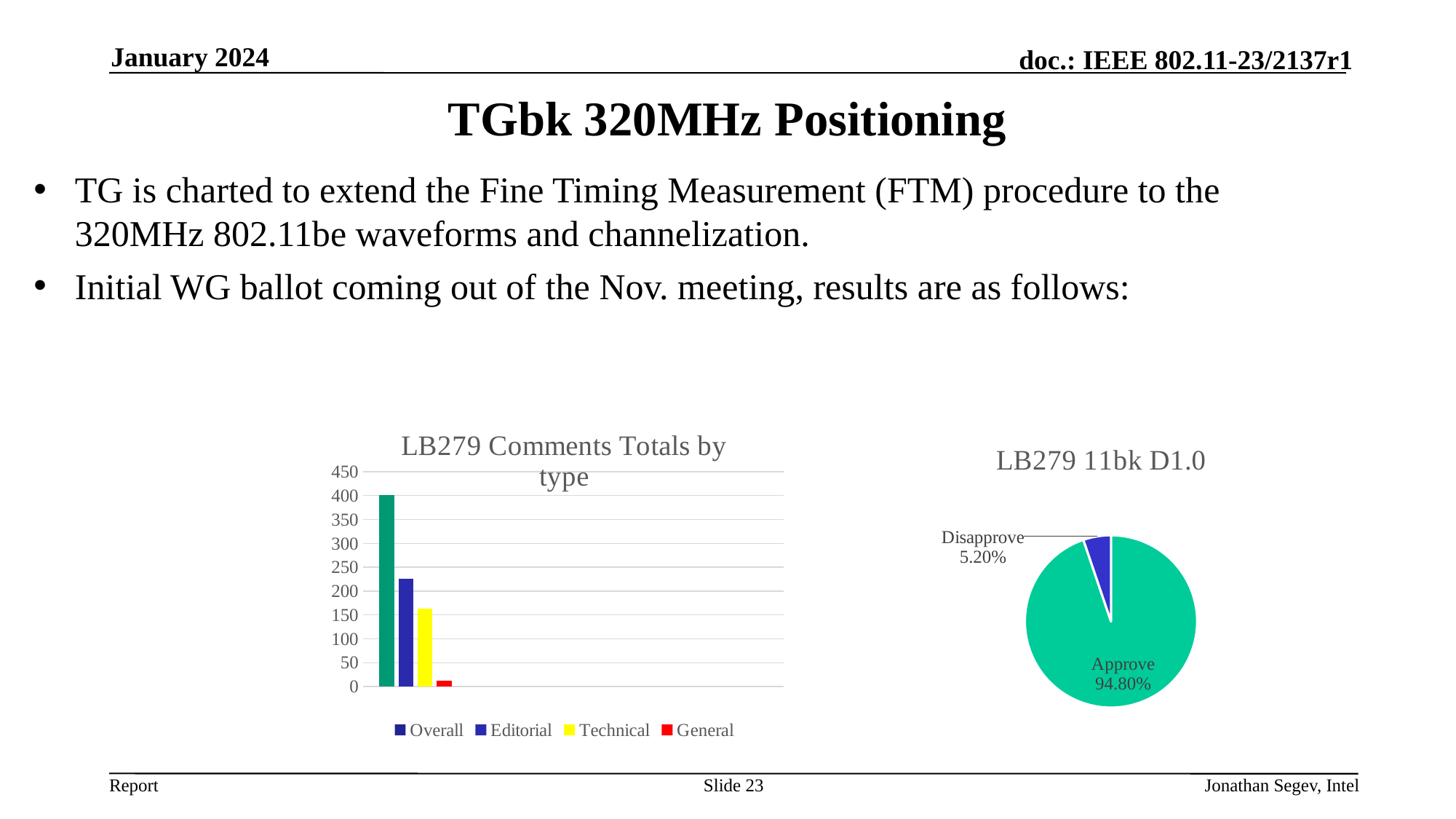
In the 'LB279 Comments Totals by type' chart, which series has the highest value? Overall In the 'LB279 Comments Totals by type' chart, is the value for General greater or less than 50? less In the 'LB279 11bk D1.0' pie chart, what share is Approve? 94.80% In the 'LB279 Comments Totals by type' chart, which is larger, Editorial or Technical? Editorial In the 'LB279 Comments Totals by type' chart, is the value for Overall greater or less than 350? greater In the 'LB279 Comments Totals by type' chart, is the value for Technical greater or less than 200? less In the 'LB279 11bk D1.0' pie chart, what share is Disapprove? 5.20% What kind of chart is the 'LB279 Comments Totals by type' chart? bar chart In the 'LB279 Comments Totals by type' chart, what colour is the Technical bar? yellow What kind of chart is the 'LB279 11bk D1.0' chart? pie chart In the 'LB279 Comments Totals by type' chart, which series has the lowest value? General In the 'LB279 Comments Totals by type' chart, how many series does the legend list? 4